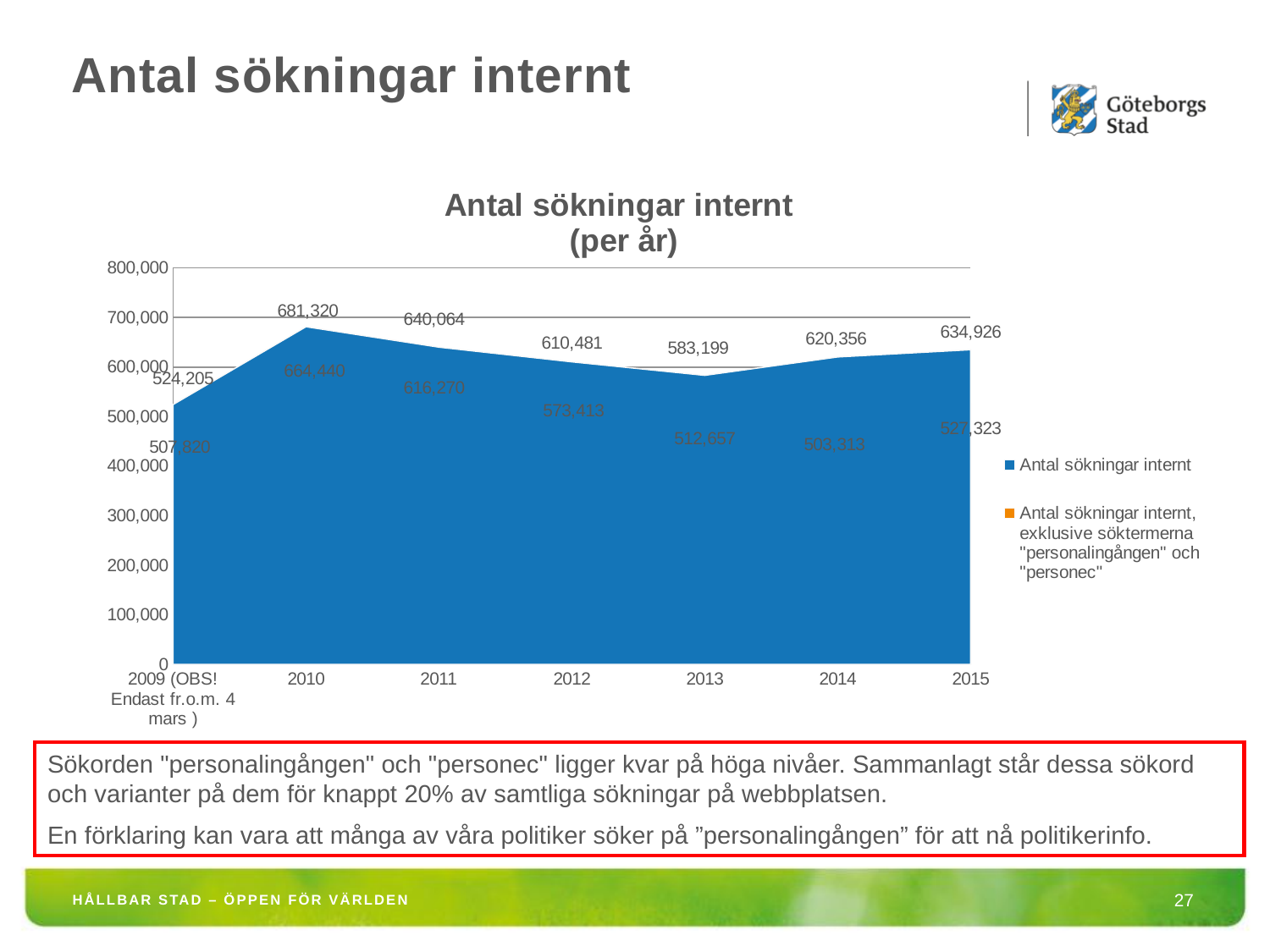
How many series does the legend list? 2 How many years are shown on the x axis? 7 Is the value for "Antal sökningar internt" in 2012 greater or less than 600,000? greater What is the value of "Antal sökningar internt" for 2015? 634,926 What kind of chart is shown? Area chart What is the title of the chart? Antal sökningar internt (per år) What is the difference between the "Antal sökningar internt" values for 2010 and 2011? 41,256 What is the value of "Antal sökningar internt" for 2013? 583,199 Which is larger for "Antal sökningar internt": 2014 or 2015? 2015 Which year has the highest value for "Antal sökningar internt"? 2010 What is the value of "Antal sökningar internt" for 2010? 681,320 Which year has the lowest value for "Antal sökningar internt"? 2009 (OBS! Endast fr.o.m. 4 mars )